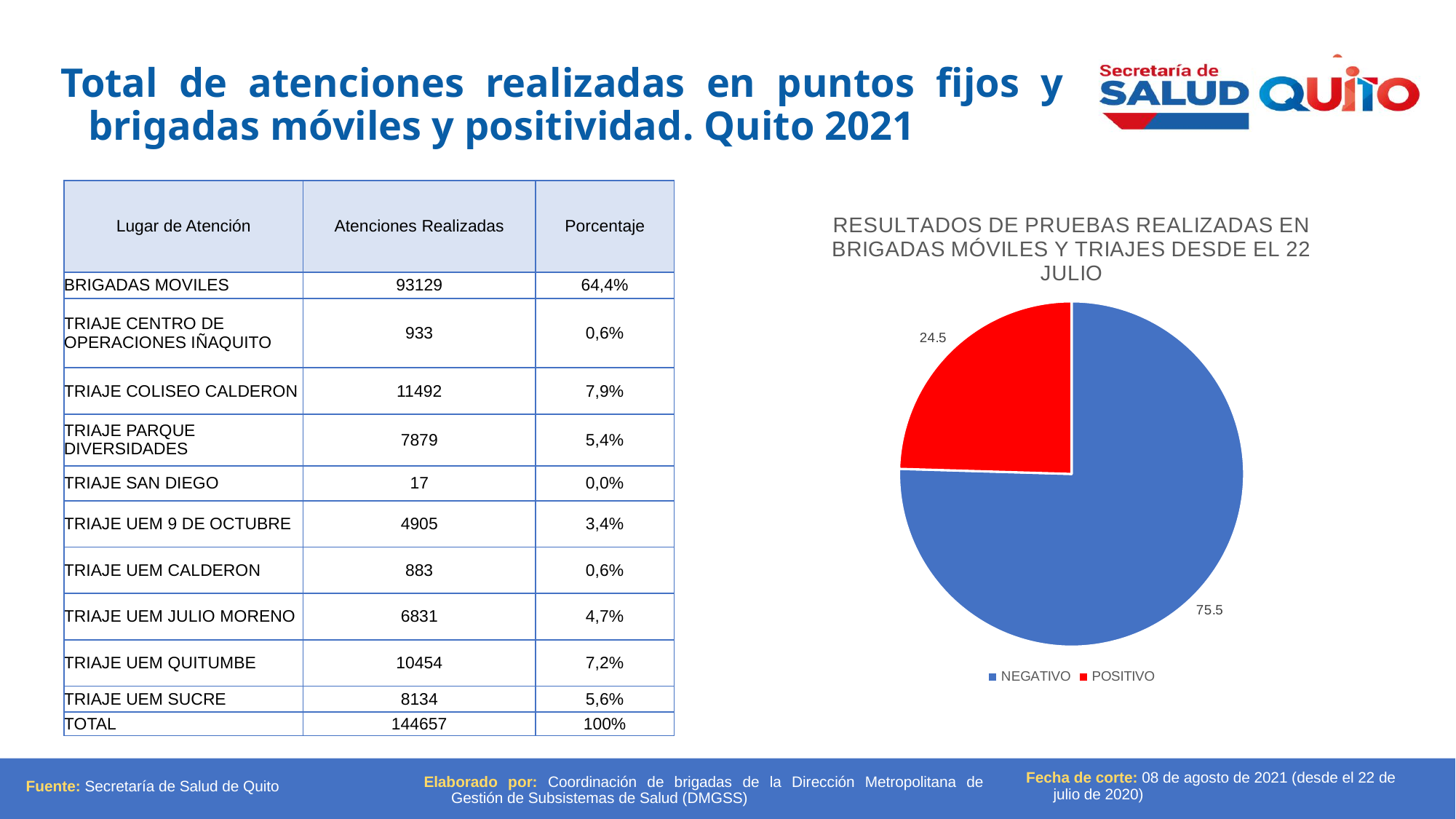
What is the value for POSITIVO in the pie chart? 24.5 What is the title of the pie chart? RESULTADOS DE PRUEBAS REALIZADAS EN BRIGADAS MÓVILES Y TRIAJES DESDE EL 22 JULIO What is the value for NEGATIVO in the pie chart? 75.5 How many slices does the pie chart have? 2 Which is larger in the pie chart, NEGATIVO or POSITIVO? NEGATIVO How many entries does the pie chart legend list? 2 What is the difference between the NEGATIVO and POSITIVO values in the pie chart? 51 Which slice of the pie chart is the smallest? POSITIVO Which slice of the pie chart is the largest? NEGATIVO What colour is the POSITIVO slice in the pie chart? red What kind of chart is shown on the slide? pie chart